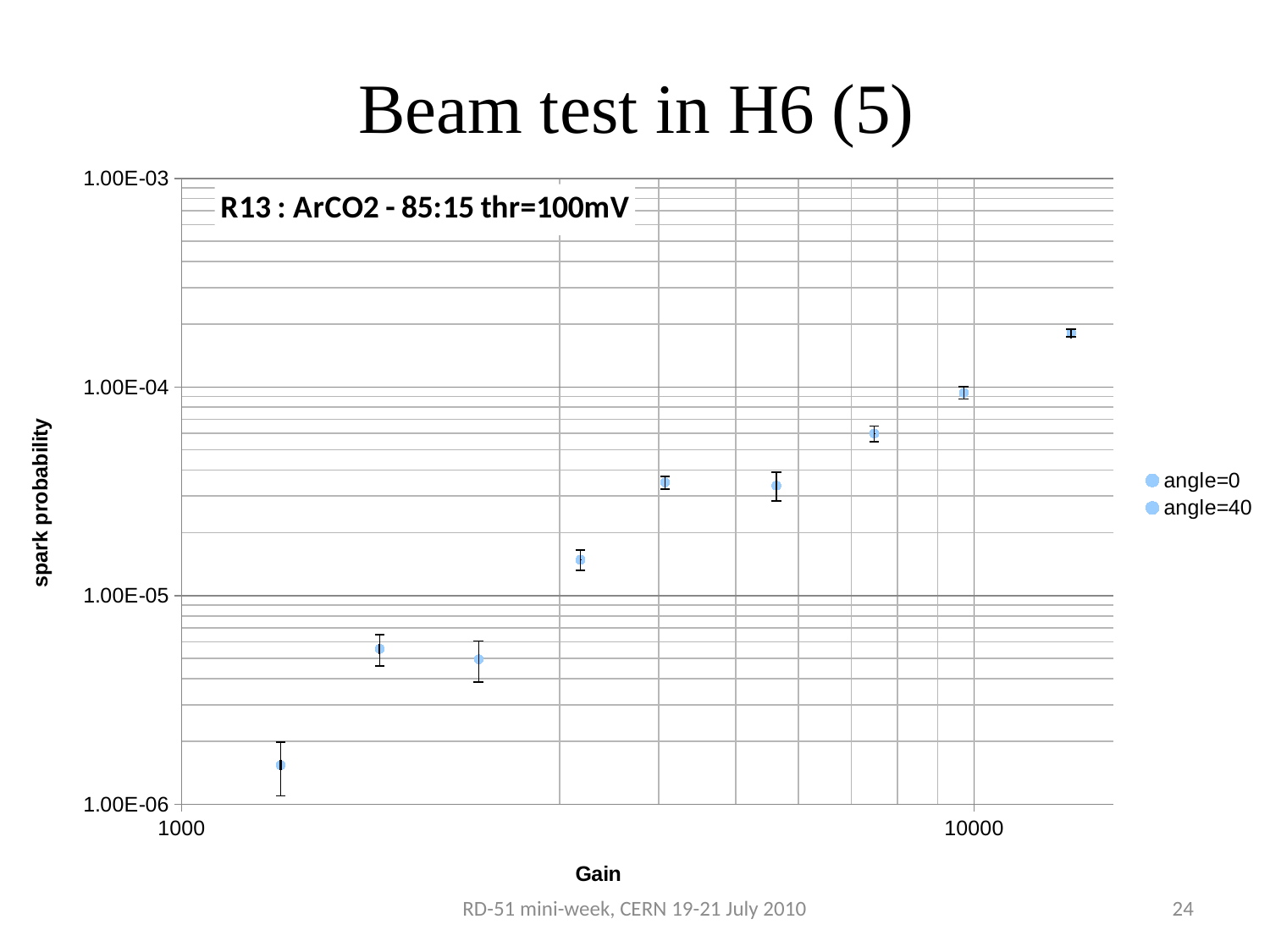
What kind of chart is shown on the slide? scatter chart Does the spark probability generally rise or fall as the gain increases? rise What are the two series named in the legend? angle=0 and angle=40 How many data points are plotted on the chart? 9 What is the title of the chart? R13 : ArCO2 - 85:15 thr=100mV Which point has the lowest spark probability? the leftmost point (lowest gain) Which point has the highest spark probability? the rightmost point (highest gain) Is the spark probability of the rightmost (highest-gain) point greater or less than 1.00E-04? greater Is the spark probability of the leftmost (lowest-gain) point greater or less than 1.00E-06? greater How many series does the legend list? 2 Is the spark probability of the leftmost (lowest-gain) point greater or less than 1.00E-05? less